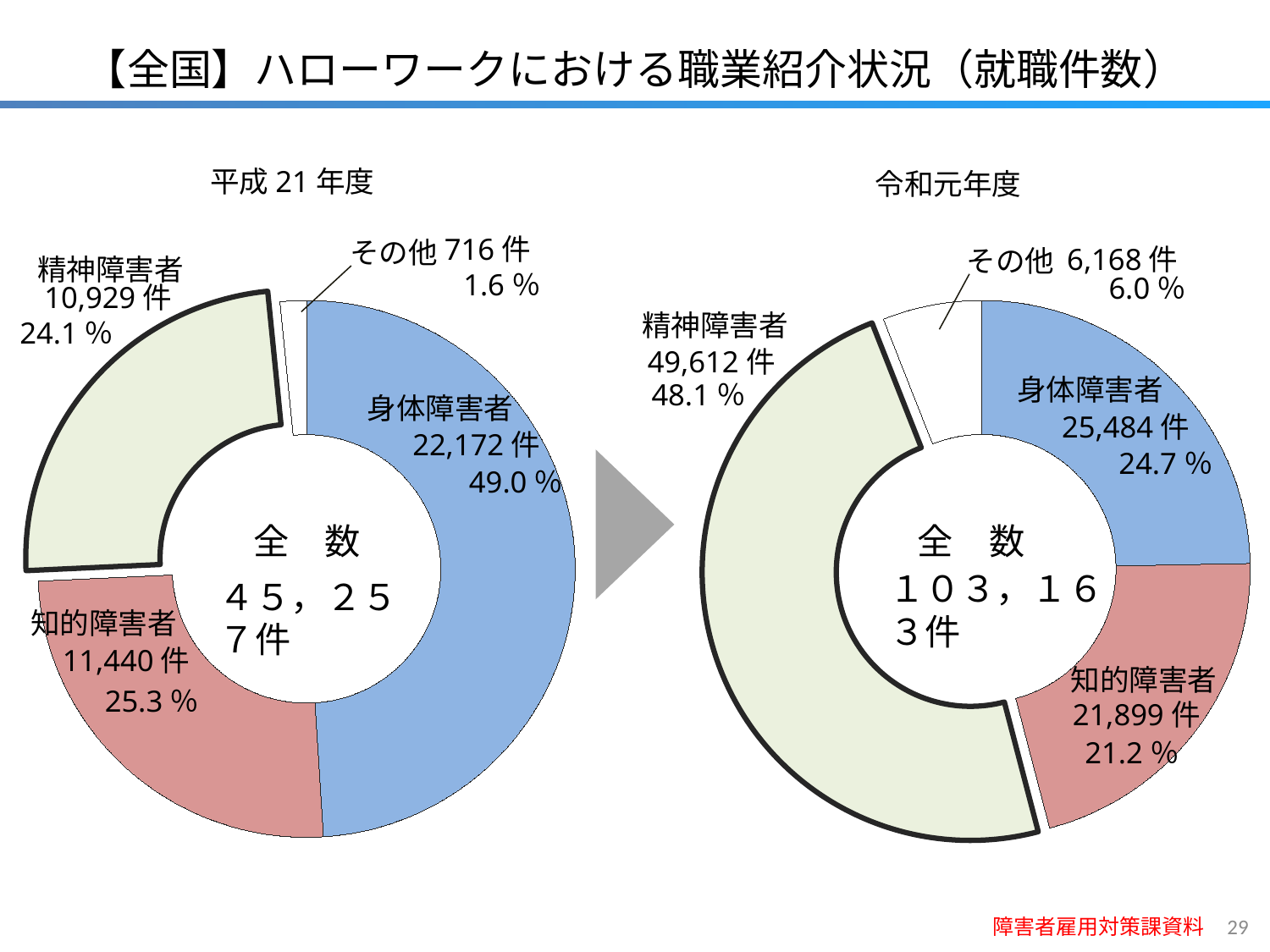
In the 平成21年度 chart, what share of the total does 精神障害者 account for? 24.1 % In the 平成21年度 chart, which category has the smallest number of cases? その他 In the 令和元年度 chart, what percentage is shown for その他? 6.0 % In the 令和元年度 chart, which has more cases, 身体障害者 or 知的障害者? 身体障害者 In the 平成21年度 chart, what is the total number of cases (全数) shown in the centre? 45,257 件 In the 令和元年度 chart, what is the difference in cases between 身体障害者 and 知的障害者? 3,585 件 In the 令和元年度 chart, which category has the largest share? 精神障害者 In the 令和元年度 chart, how many cases (件) are shown for 精神障害者? 49,612 件 What type of chart is used for 令和元年度? Donut (pie) chart What is the total number of cases (全数) shown in the centre of the 令和元年度 chart? 103,163 件 How many categories are shown in the 平成21年度 chart? 4 In the 平成21年度 chart, how many cases (件) are shown for 身体障害者? 22,172 件